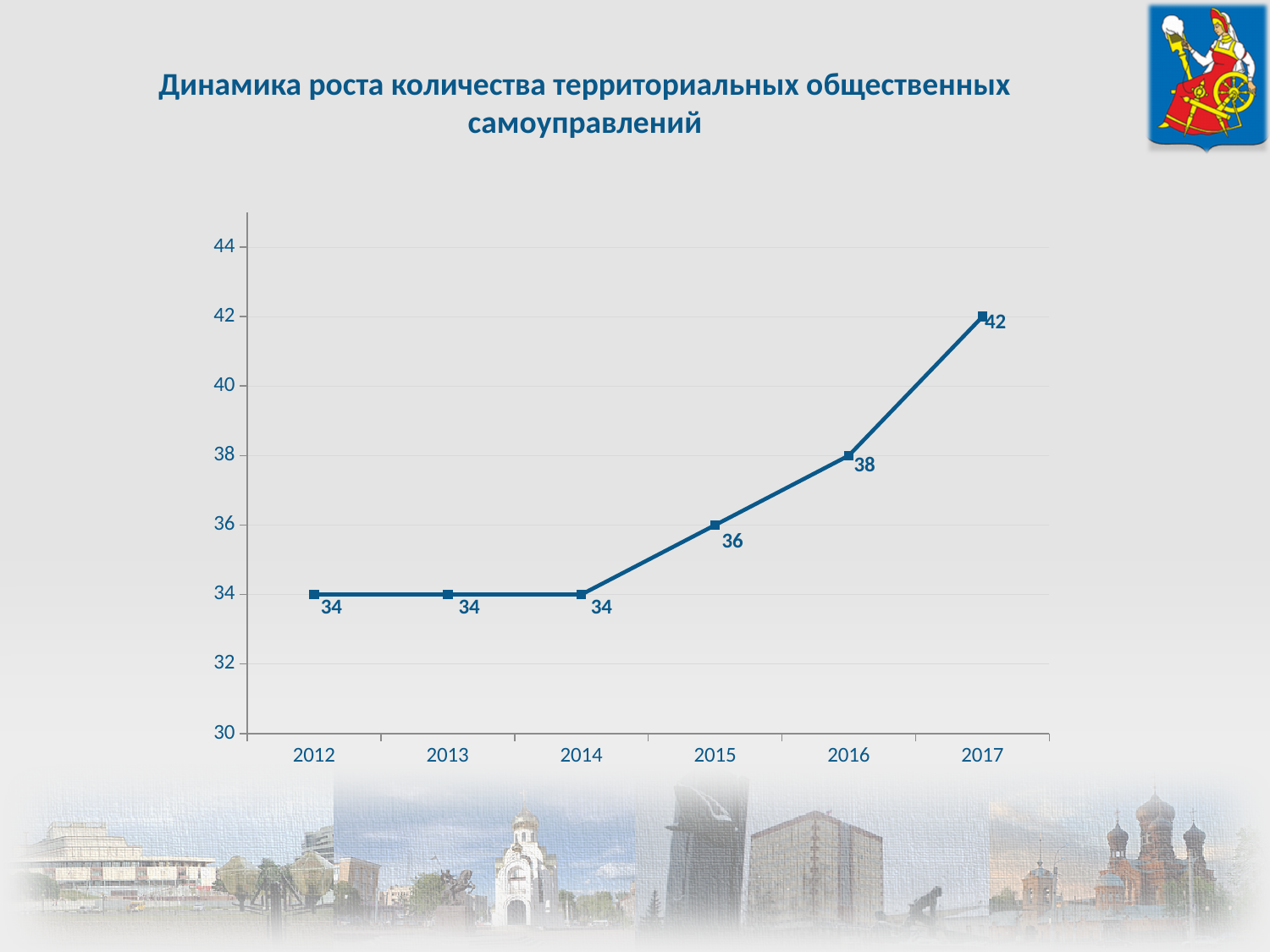
How many years are plotted on the x axis? 6 Which is larger, the value for 2016 or the value for 2015? 2016 What is the value for 2012? 34 What is the difference between the values for 2015 and 2014? 2 Do the values rise or fall from 2014 to 2017? rise Which year has the highest value? 2017 What kind of chart is shown on the slide? line chart What is the difference between the values for 2017 and 2016? 4 What is the value for 2015? 36 What is the value for 2017? 42 Is the value for 2017 greater or less than 40? greater What is the title of the chart? Динамика роста количества территориальных общественных самоуправлений